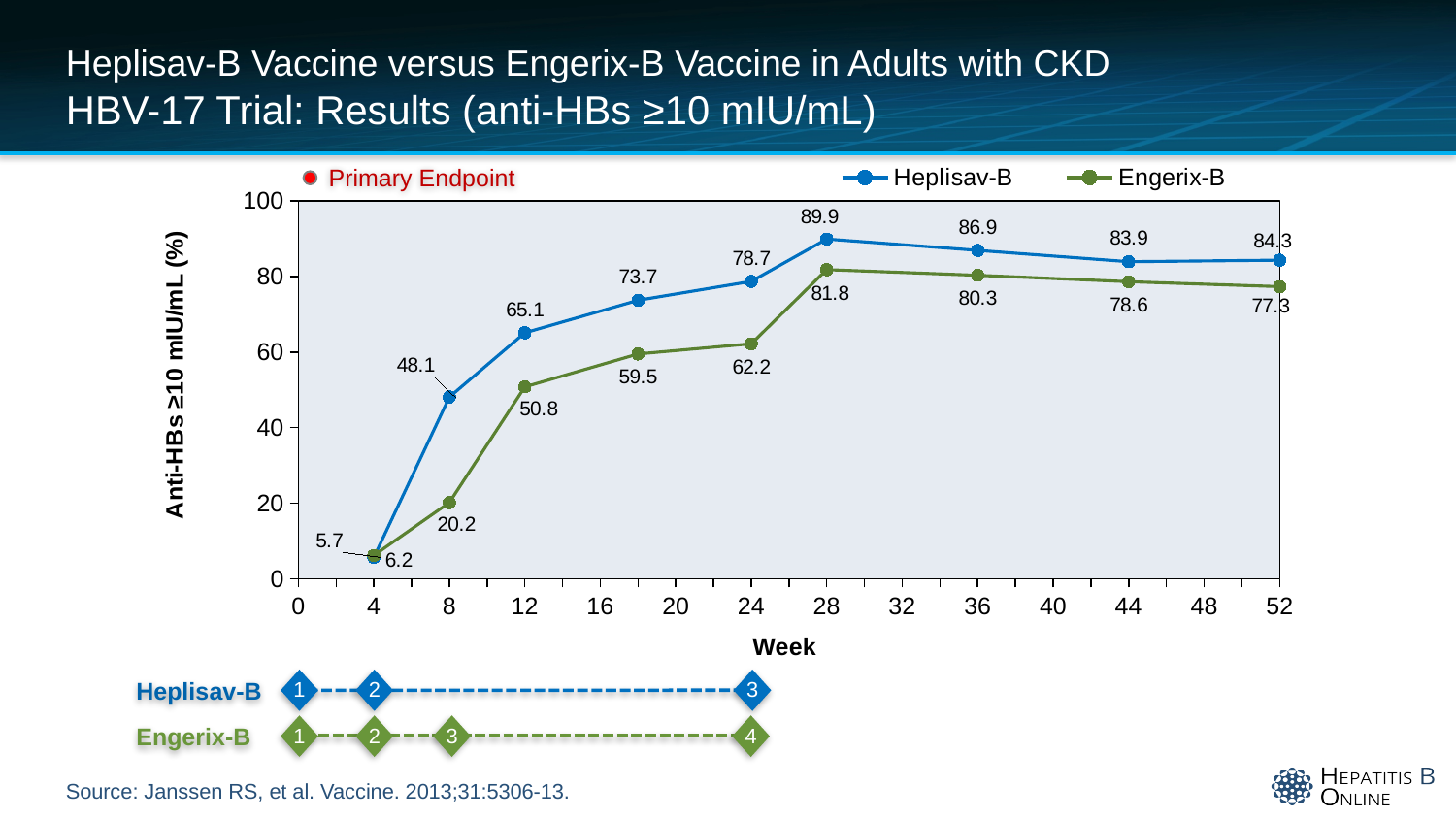
At which week does Heplisav-B reach its highest value? Week 28 What is the Heplisav-B value at week 28? 89.9 Does the Heplisav-B line rise or fall from week 4 to week 28? Rises What is the label on the y-axis? Anti-HBs ≥10 mIU/mL (%) At week 4, which series has the higher value, Heplisav-B or Engerix-B? Engerix-B What kind of chart is shown? Line chart What is the Engerix-B value at week 52? 77.3 What is the Engerix-B value at week 12? 50.8 How many series does the legend list? 2 What is the difference between the Heplisav-B and Engerix-B values at week 8? 27.9 At which week is the Engerix-B value lowest? Week 4 What is the difference between the Heplisav-B and Engerix-B values at week 52? 7.0